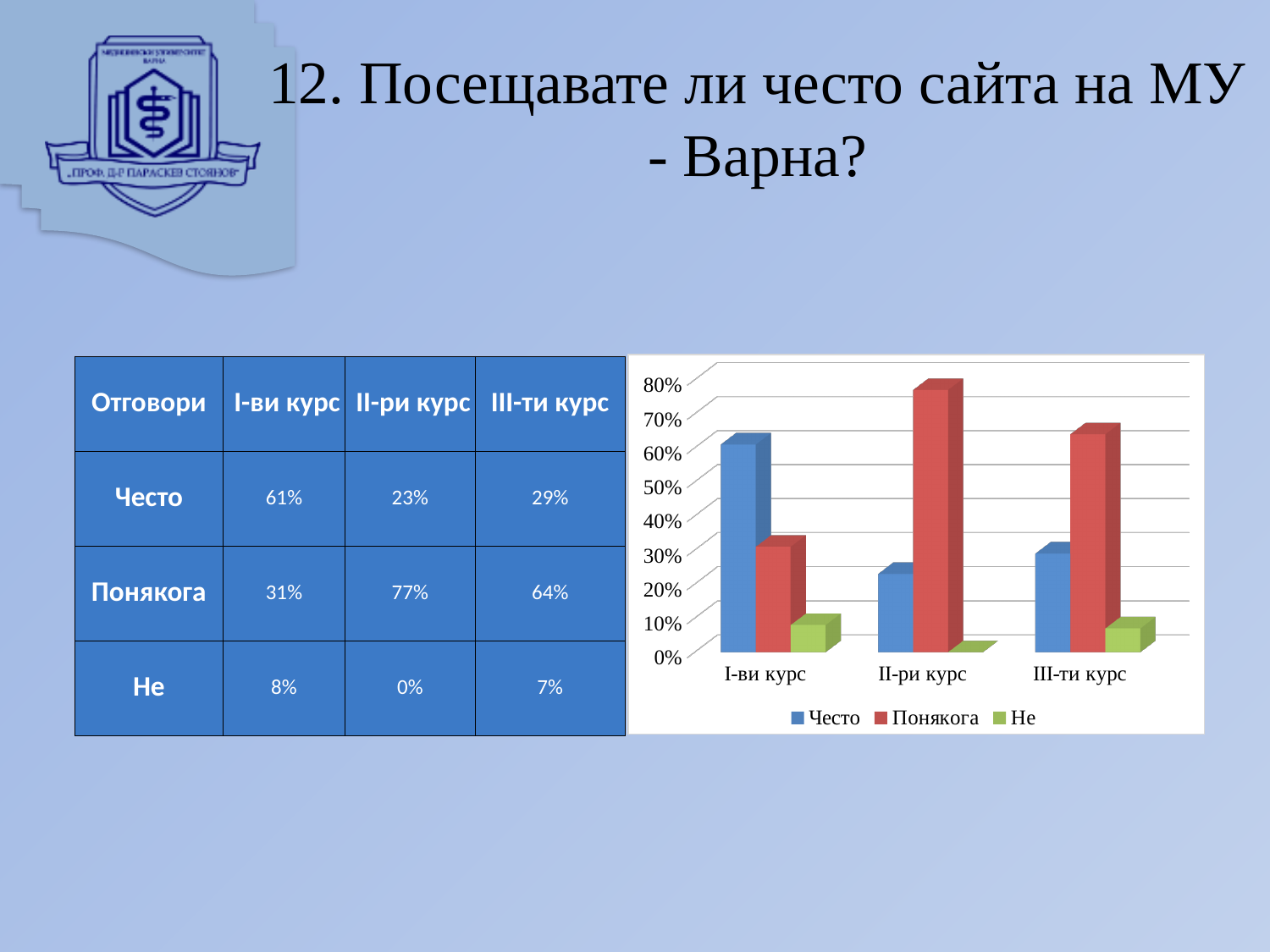
What is the value for "Често" for I-ви курс? 61% What is the difference between the "Понякога" values for II-ри курс and I-ви курс? 46% Which course has the highest value for "Понякога"? II-ри курс How many categories are shown on the x axis of the chart? 3 For III-ти курс, which is larger: "Често" or "Понякога"? Понякога How many series does the chart legend list? 3 What is the value for "Не" for III-ти курс? 7% What kind of chart is shown on the slide? bar chart Which course has the lowest value for "Не"? II-ри курс What is the value for "Понякога" for II-ри курс? 77% Is the value for "Често" for I-ви курс greater or less than 50%? greater Which colour represents the "Не" series in the chart? green